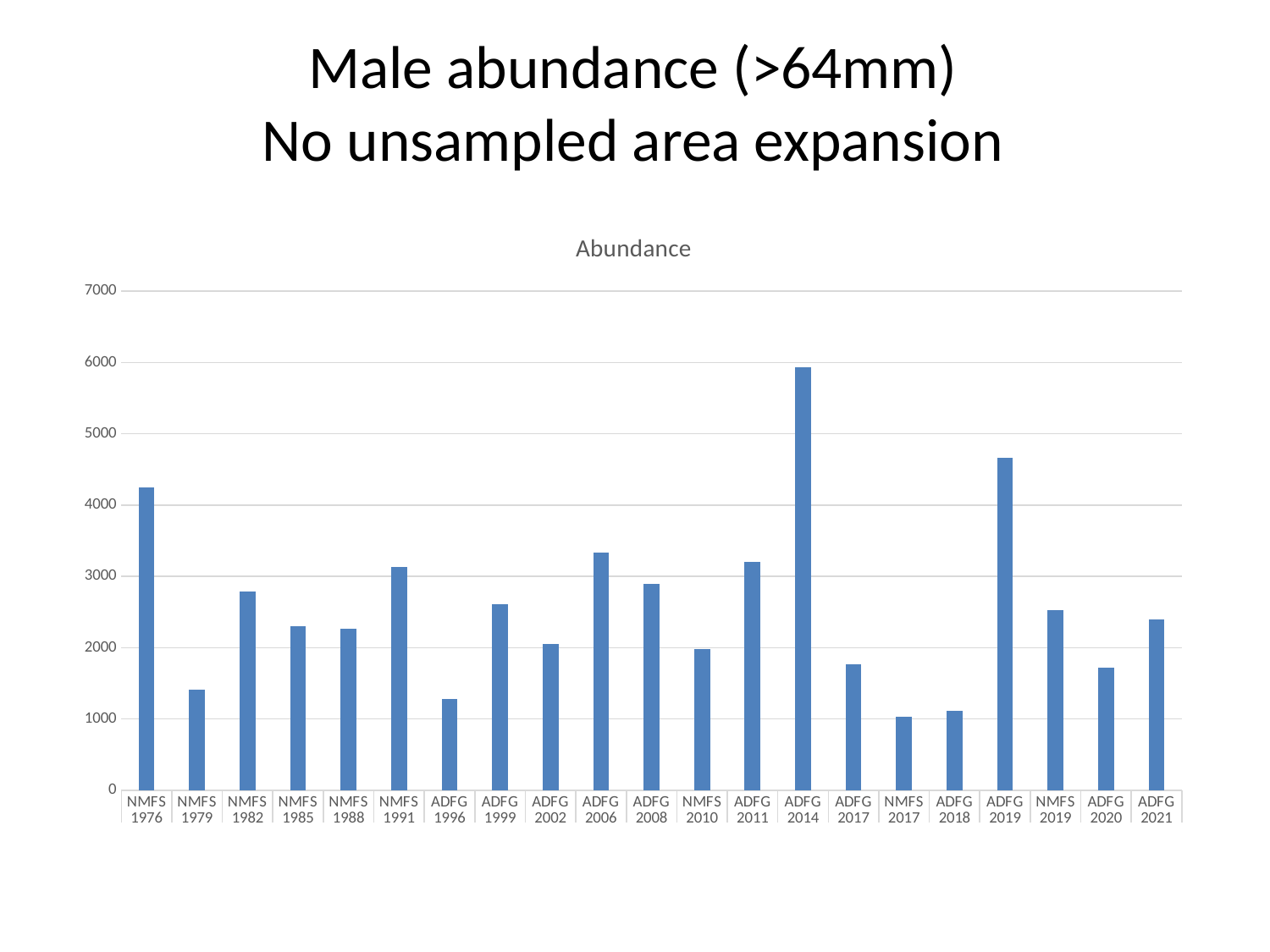
Which is larger, the value for ADFG 2019 or the value for NMFS 1976? ADFG 2019 Which category has the highest abundance? ADFG 2014 How many bars (survey-year categories) are plotted in the chart? 21 Is the value for ADFG 2006 greater or less than 3000? greater Is the value for ADFG 2014 greater or less than 5000? greater Is the value for ADFG 2019 greater or less than 5000? less What kind of chart is shown on the slide? Bar chart What is the title shown directly above the chart's plot area? Abundance Which is larger, the value for ADFG 2006 or the value for ADFG 2008? ADFG 2006